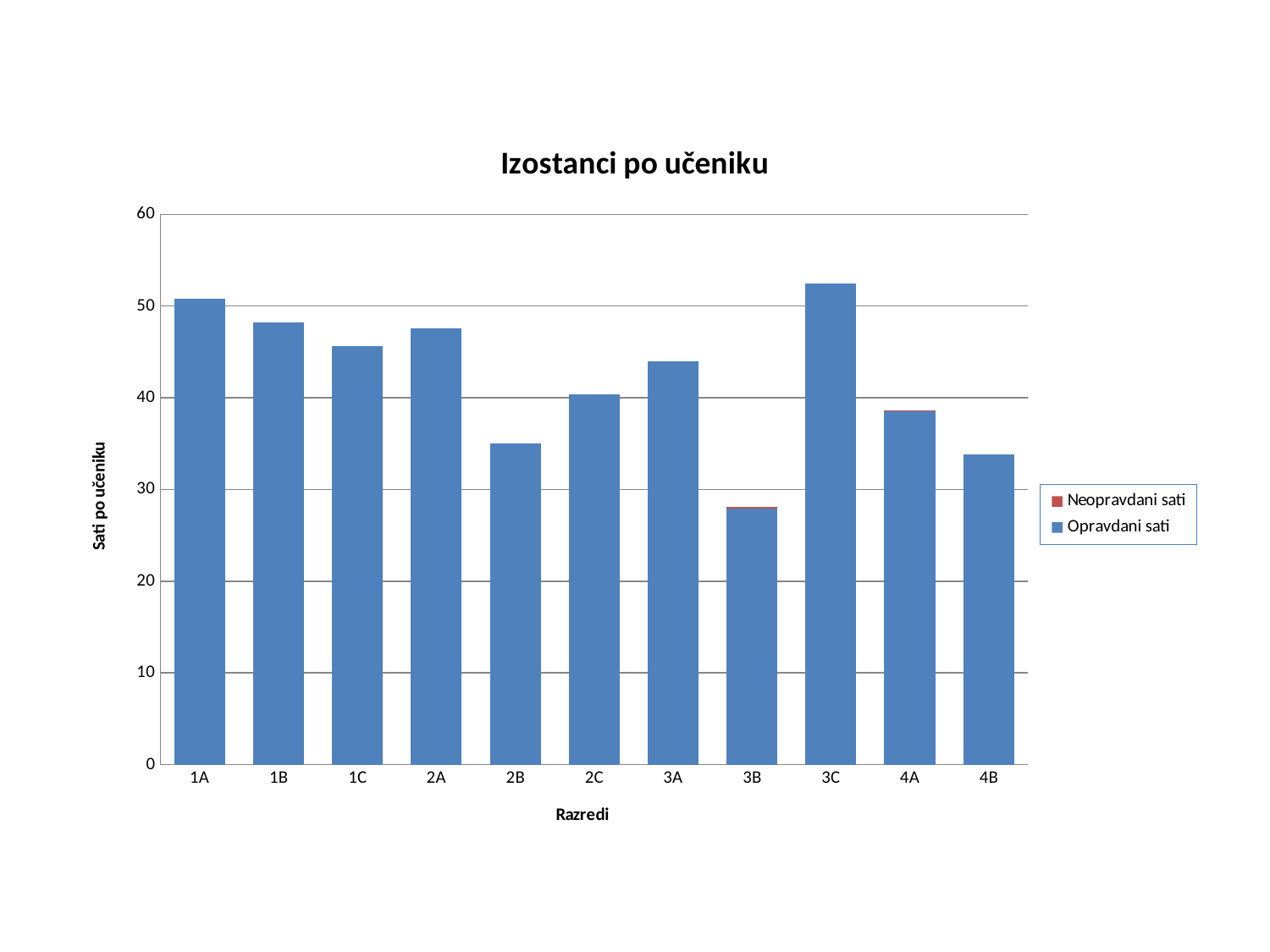
Is the value for 3B greater or less than 30? less What type of chart is shown on the slide? bar chart Is the value for 2B greater or less than 40? less How many classes (categories) are shown on the x axis? 11 What is the title of the chart? Izostanci po učeniku Which is larger, the bar for 2C or the bar for 3A? 3A What is the label of the y axis? Sati po učeniku Which class has the highest bar? 3C Is the value for 1A greater or less than 50? greater How many series does the legend list? 2 Which is larger, the bar for 1B or the bar for 4A? 1B Which class has the lowest bar? 3B